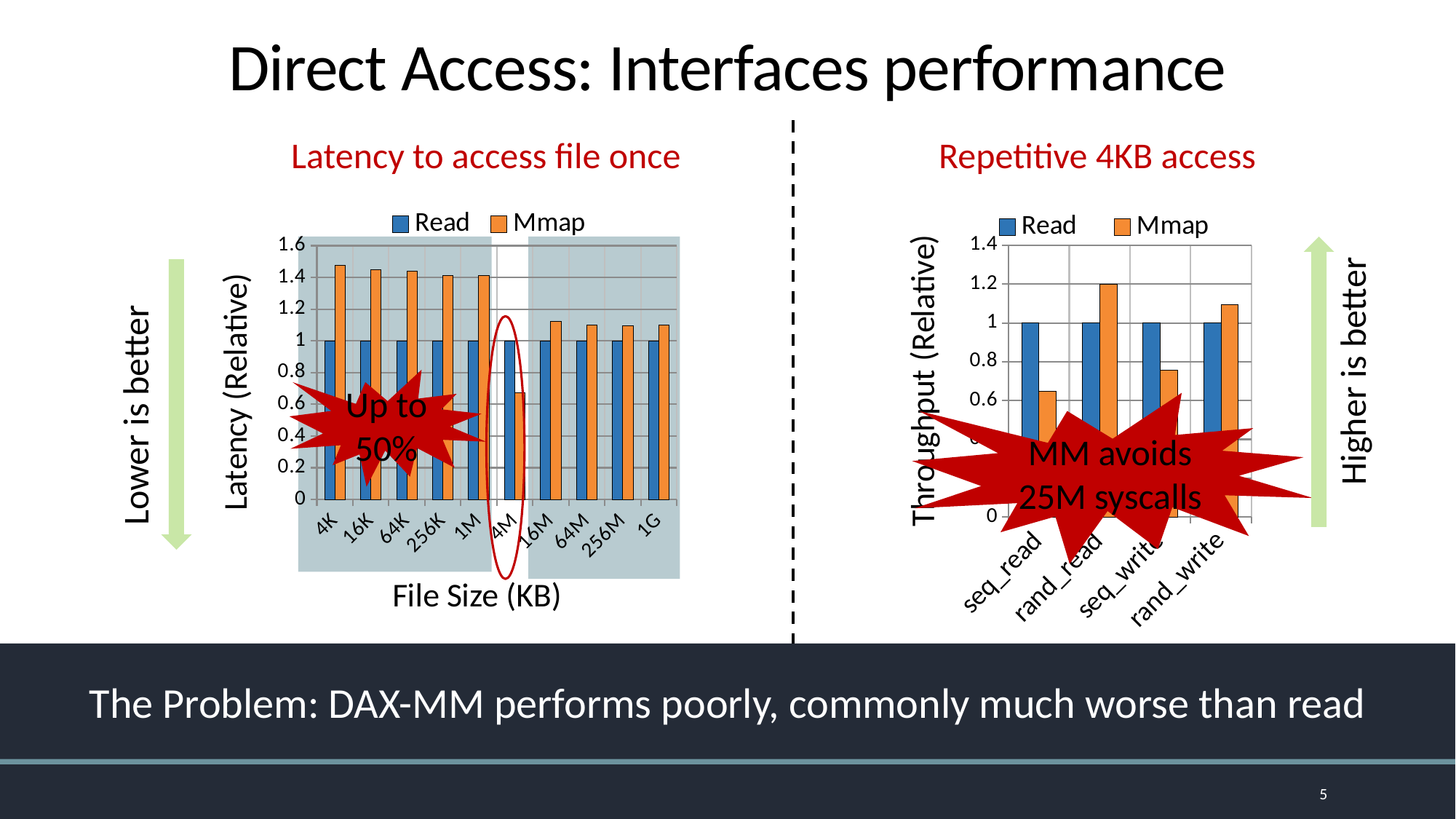
How many file size categories are shown on the x axis of the 'Latency to access file once' chart? 10 In the 'Repetitive 4KB access' chart, which is larger for seq_write, Read or Mmap? Read In the 'Repetitive 4KB access' chart, which category has the highest Mmap value? rand_read How many series does the legend of the 'Repetitive 4KB access' chart list? 2 In the 'Repetitive 4KB access' chart, is the Mmap value for seq_read greater or less than 0.8? less In the 'Latency to access file once' chart, is the Mmap value for 4M greater or less than 0.8? less In the 'Latency to access file once' chart, is the Mmap value for 4K greater or less than 1.4? greater In the 'Repetitive 4KB access' chart, what is the Read value for seq_write? 1 How many categories are shown on the x axis of the 'Repetitive 4KB access' chart? 4 In the 'Latency to access file once' chart, what is the Read value for 4K? 1 What kind of chart is the 'Latency to access file once' chart on the left? bar chart In the 'Latency to access file once' chart, which file size has the lowest Mmap value? 4M